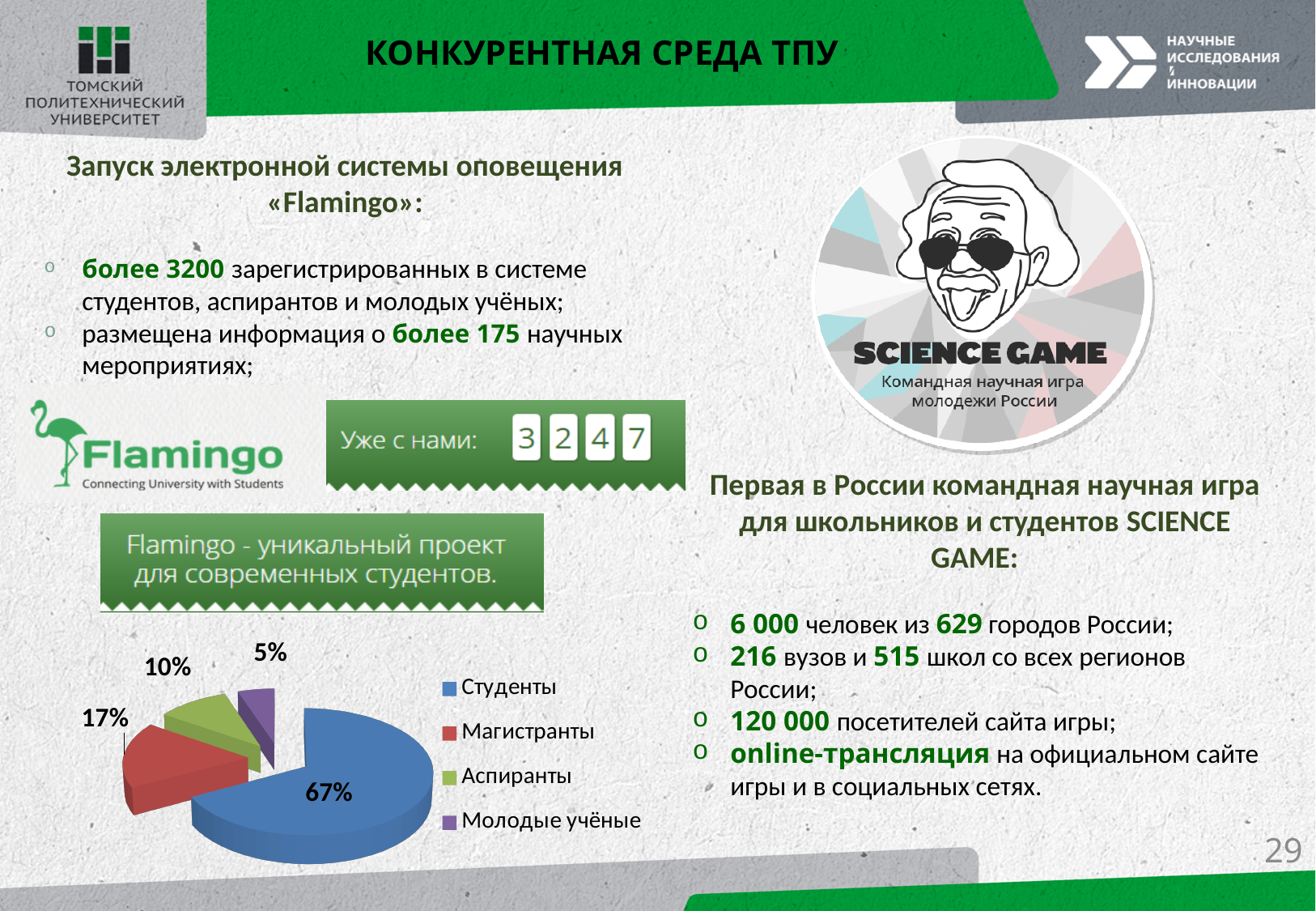
What colour is the Студенты slice in the pie chart? blue What kind of chart is shown on the slide? pie chart Which category has the largest slice in the pie chart? Студенты What share of the pie chart is Студенты? 67% What share of the pie chart is Молодые учёные? 5% What share of the pie chart is Магистранты? 17% What is the difference in percentage points between Студенты and Магистранты in the pie chart? 50 What share of the pie chart is Аспиранты? 10% What is the difference in percentage points between Аспиранты and Молодые учёные in the pie chart? 5 Which is larger in the pie chart, Магистранты or Аспиранты? Магистранты How many categories does the pie chart legend list? 4 Which category has the smallest slice in the pie chart? Молодые учёные